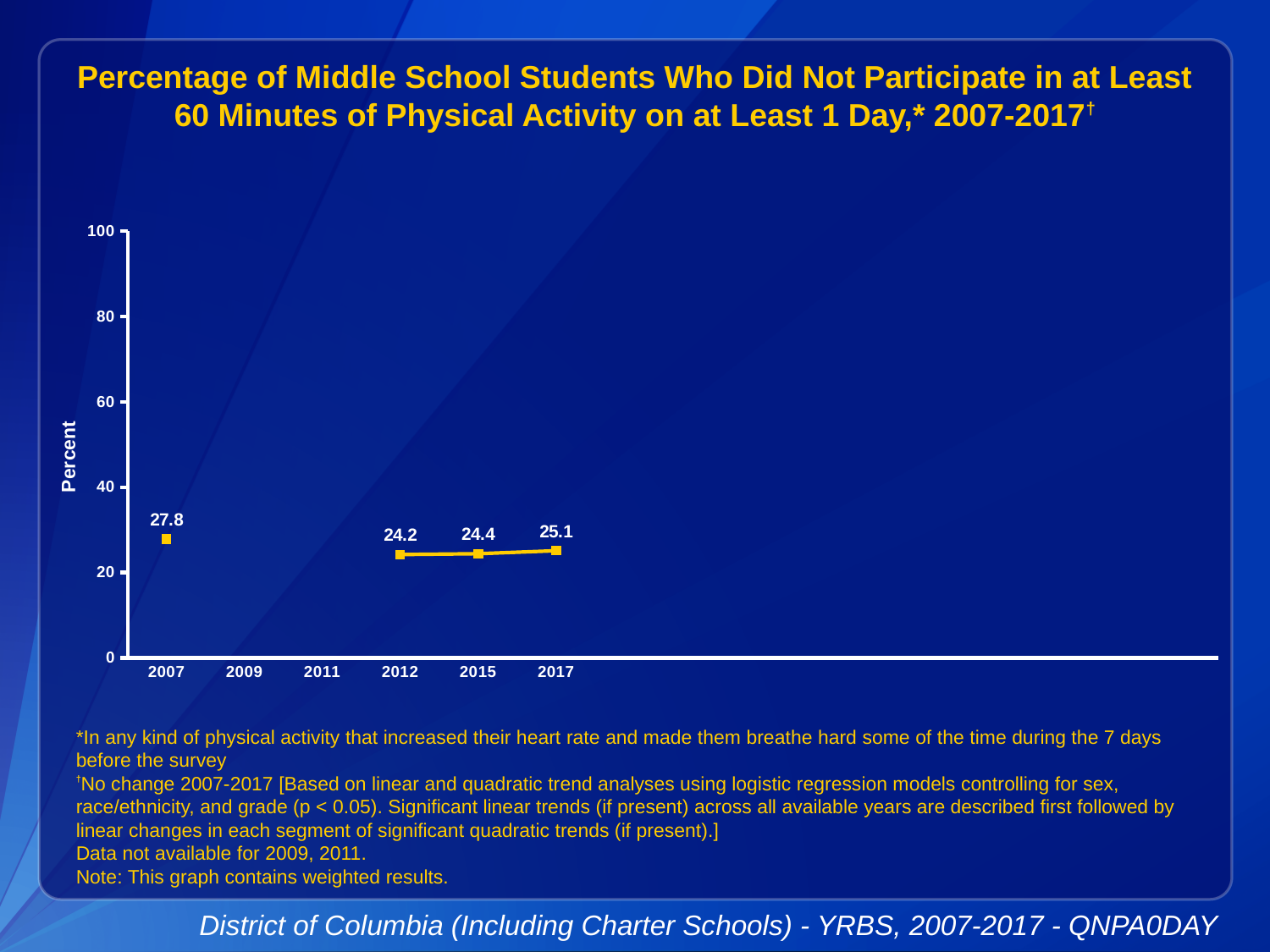
What is the value for 2017? 25.1 What kind of chart is shown? line chart What is the value for 2015? 24.4 What is the value for 2007? 27.8 Which is larger, the value for 2007 or the value for 2012? 2007 What is the value for 2012? 24.2 Which year has the lowest value? 2012 What is the label on the y axis? Percent What is the difference between the values for 2007 and 2017? 2.7 Is the value for 2017 greater or less than 40? less How many years have a plotted data point? 4 Which year has the highest value? 2007